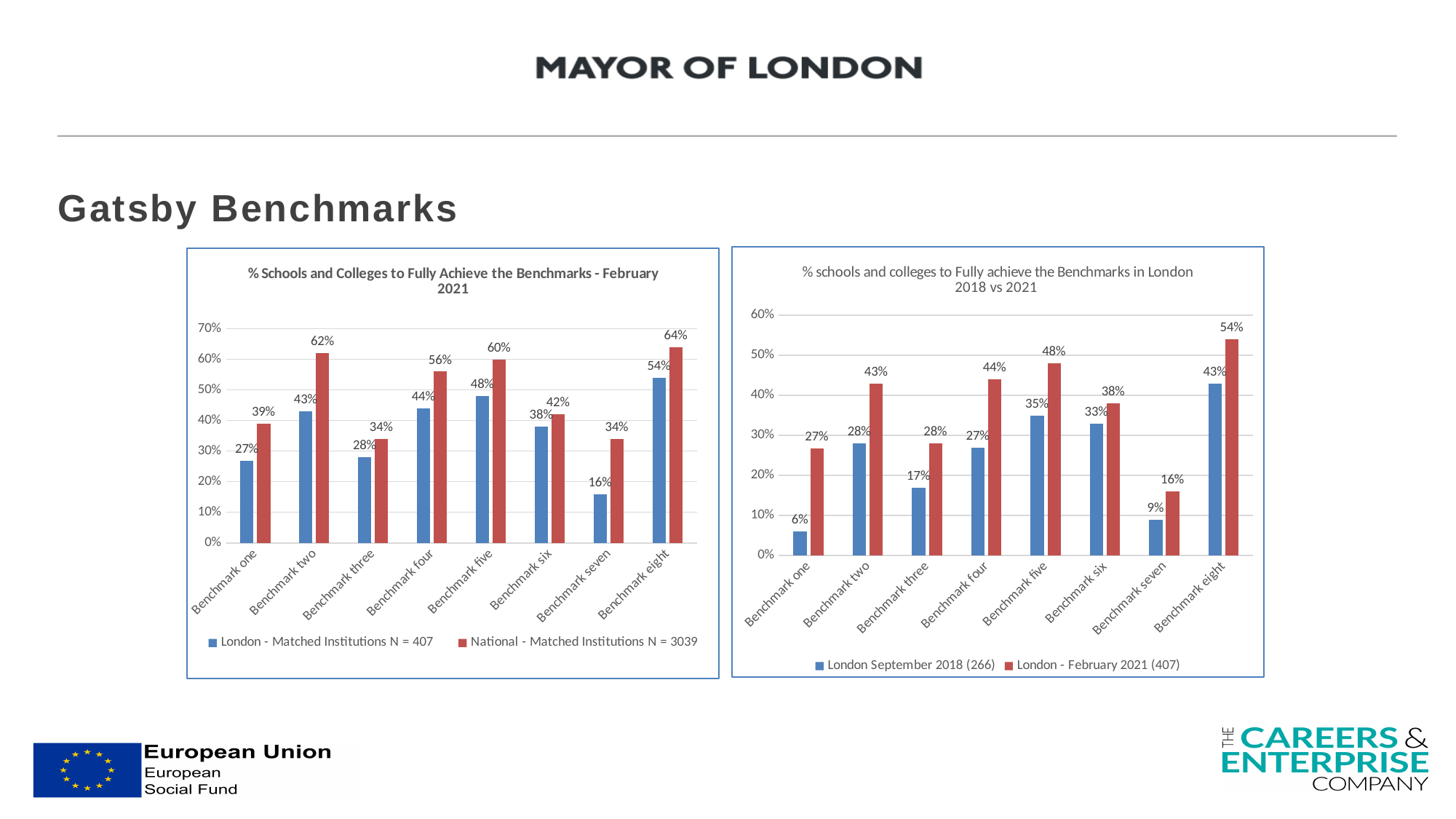
In the right chart (London 2018 vs 2021), how many benchmark categories are shown on the x axis? 8 In the left chart (February 2021, London vs National), what is the difference between the National and London values at Benchmark two? 19% In the right chart (London 2018 vs 2021), what is the difference between the 2021 and 2018 values at Benchmark one? 21% In the left chart (February 2021, London vs National), which benchmark has the lowest London - Matched Institutions value? Benchmark seven In the right chart (London 2018 vs 2021), what is the value for London - February 2021 at Benchmark eight? 54% In the left chart (February 2021, London vs National), how many series does the legend list? 2 In the left chart (February 2021, London vs National), which benchmark has the highest National - Matched Institutions value? Benchmark eight In the right chart (London 2018 vs 2021), what is the value for London September 2018 at Benchmark one? 6% In the left chart (February 2021, London vs National), what is the value for National - Matched Institutions at Benchmark two? 62% What kind of chart is the right chart (London 2018 vs 2021)? Bar chart In the left chart (February 2021, London vs National), what is the value for London - Matched Institutions at Benchmark five? 48% In the right chart (London 2018 vs 2021), which benchmark has the lowest London - February 2021 value? Benchmark seven